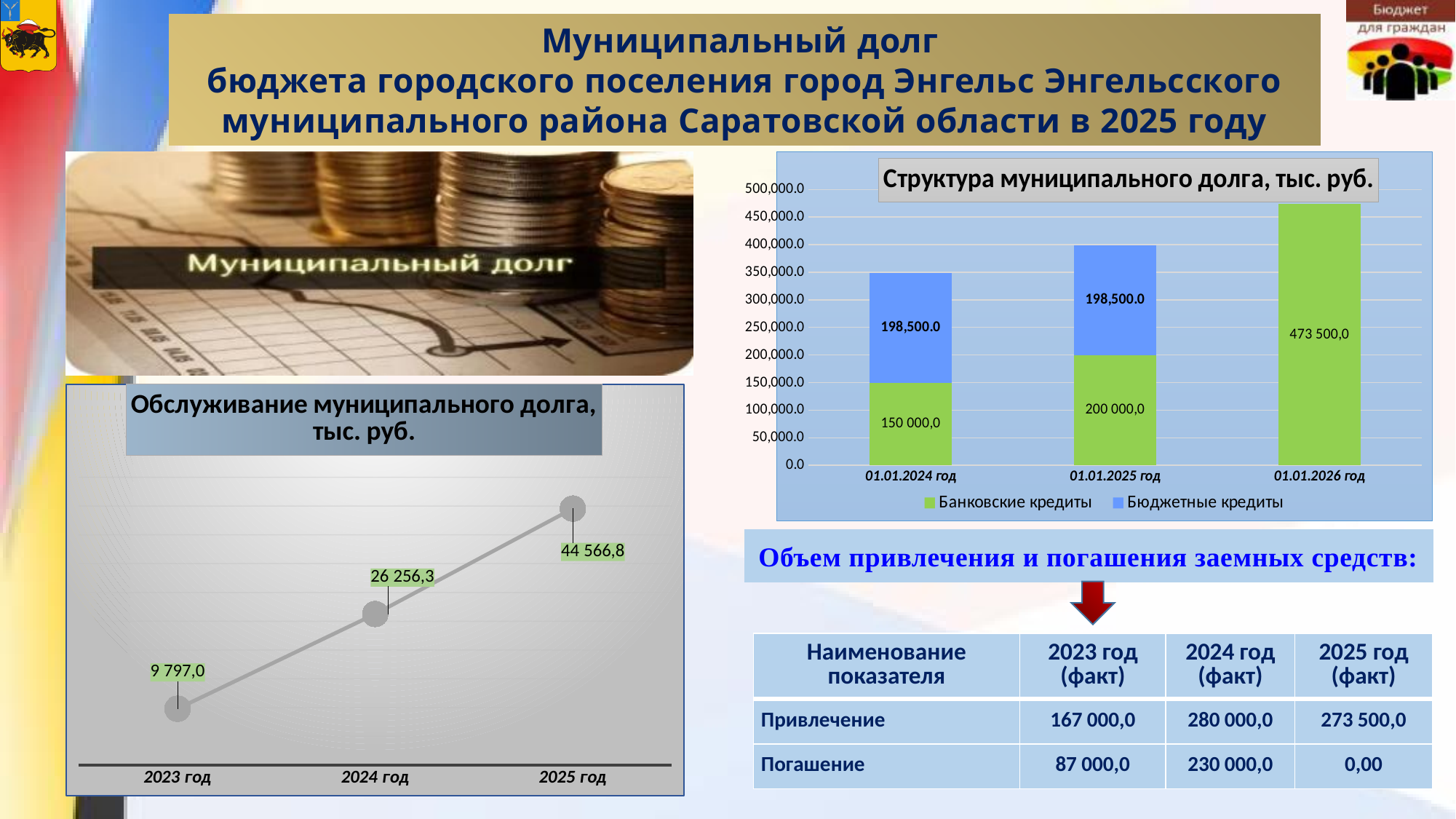
In the chart 'Структура муниципального долга, тыс. руб.', what is the value of Банковские кредиты for 01.01.2025 год? 200 000,0 In the chart 'Структура муниципального долга, тыс. руб.', which series is shown in green? Банковские кредиты In the chart 'Структура муниципального долга, тыс. руб.', which date has the highest total bar? 01.01.2026 год In the chart 'Обслуживание муниципального долга, тыс. руб.', what is the difference between the 2025 год and 2023 год values? 34 769,8 In the chart 'Обслуживание муниципального долга, тыс. руб.', what is the value for 2025 год? 44 566,8 In the chart 'Структура муниципального долга, тыс. руб.', what is the value of Бюджетные кредиты for 01.01.2024 год? 198,500.0 In the chart 'Структура муниципального долга, тыс. руб.', what is the value of Банковские кредиты for 01.01.2026 год? 473 500,0 In the chart 'Обслуживание муниципального долга, тыс. руб.', which year has the lowest value? 2023 год In the chart 'Обслуживание муниципального долга, тыс. руб.', what is the value for 2024 год? 26 256,3 In the chart 'Обслуживание муниципального долга, тыс. руб.', do the values rise or fall from 2023 год to 2025 год? rise What kind of chart is 'Обслуживание муниципального долга, тыс. руб.'? line chart How many series does the legend of the chart 'Структура муниципального долга, тыс. руб.' list? 2